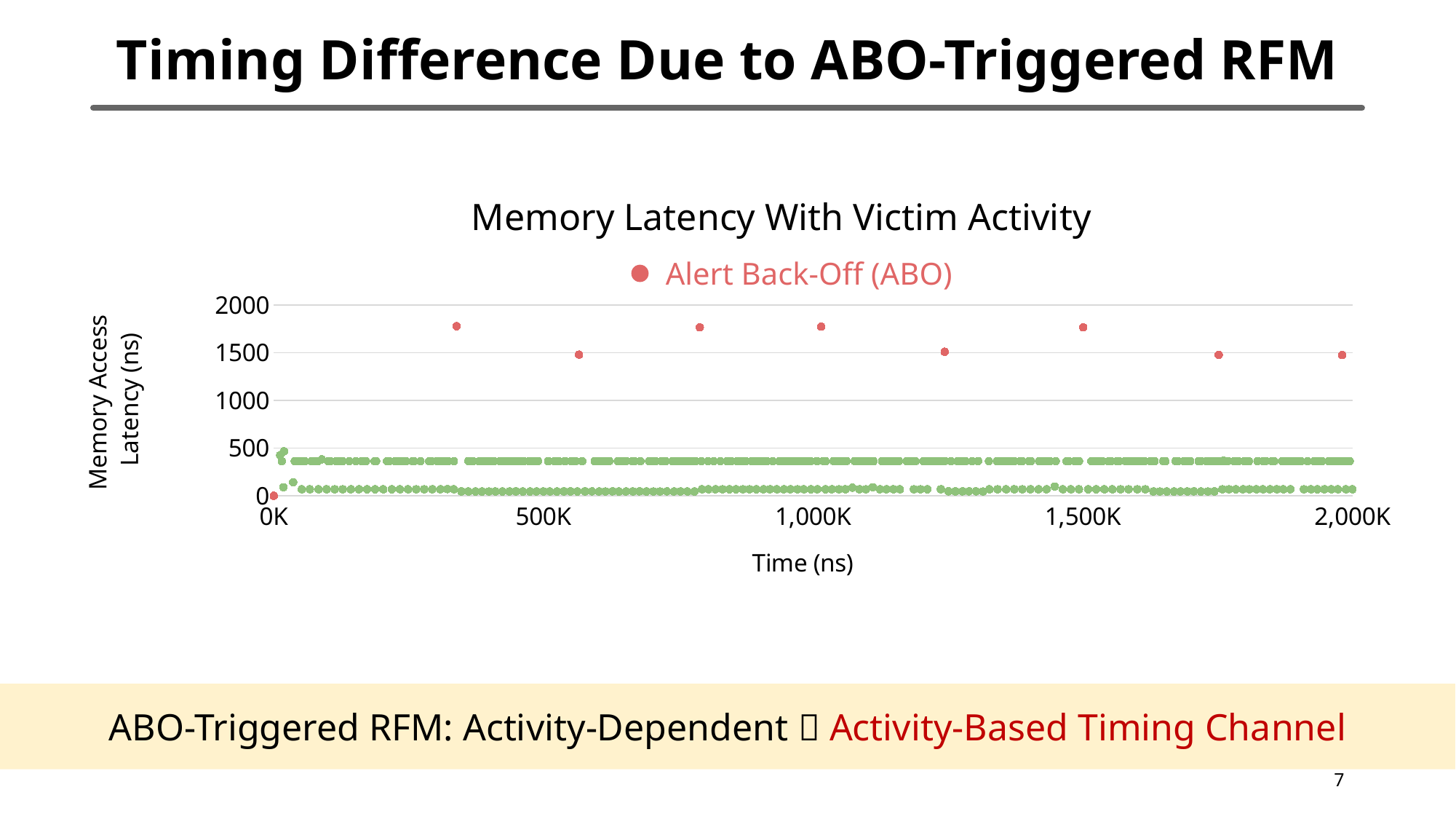
Is the upper band of green points (around the 500K to 2,000K range) greater or less than 1000? less How many series does the chart legend list? 1 How many red Alert Back-Off (ABO) points lie above 1000 ns on the chart? 8 What is the label of the y axis? Memory Access Latency (ns) What is the highest tick value shown on the x axis? 2,000K Are the red Alert Back-Off (ABO) points above 1000 ns greater or less than 1000? greater What is the label of the x axis? Time (ns) Which colour are the Alert Back-Off (ABO) points plotted in? red What kind of chart is shown on the slide? scatter chart What is the title of the chart? Memory Latency With Victim Activity What series name appears in the chart legend? Alert Back-Off (ABO) What is the highest tick value shown on the y axis? 2000